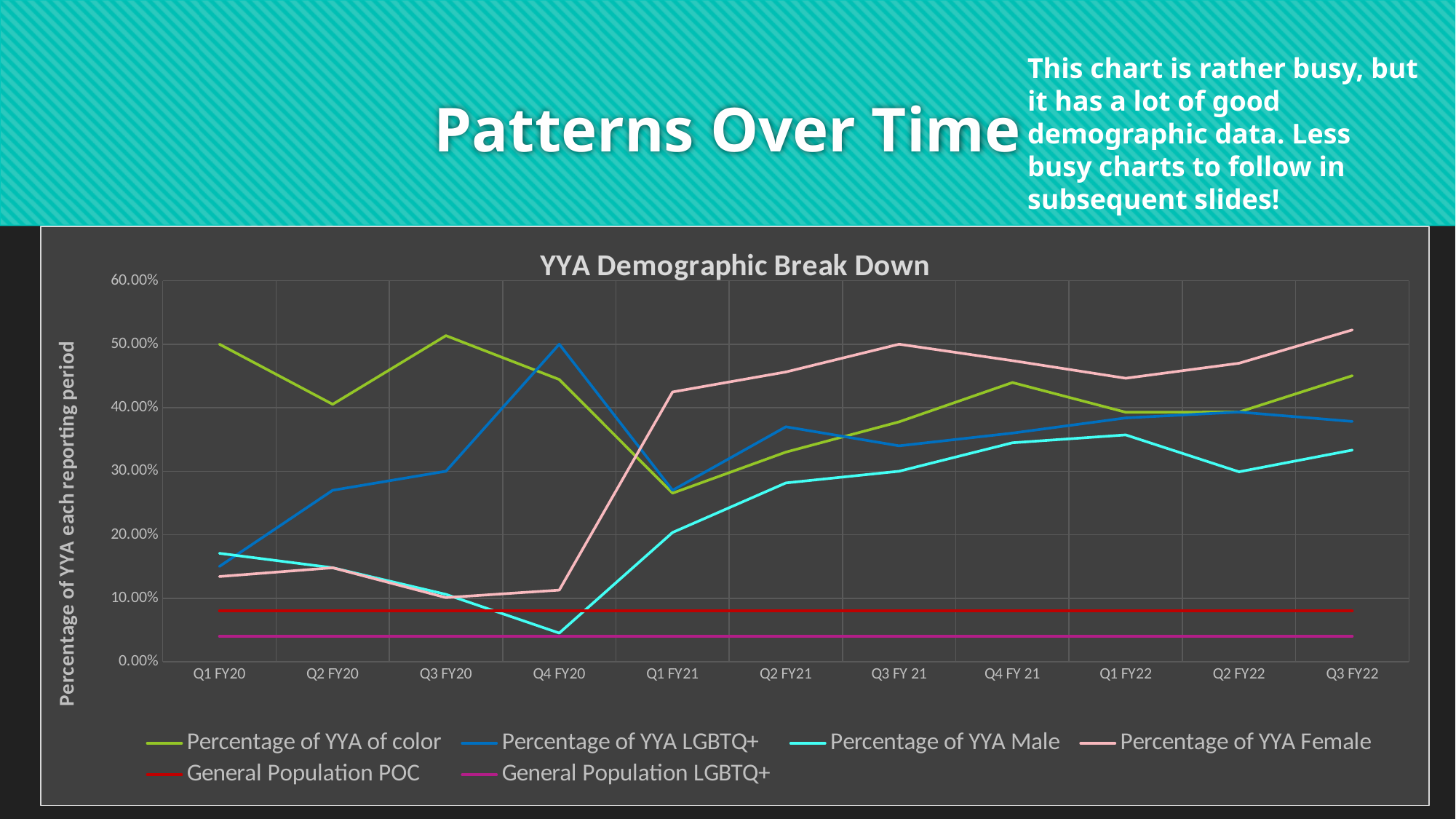
How many series does the legend of the YYA Demographic Break Down chart list? 6 At Q1 FY20, which is higher: Percentage of YYA of color or Percentage of YYA LGBTQ+? Percentage of YYA of color How many reporting periods are shown along the x axis of the chart? 11 Is the value for Percentage of YYA Male at Q4 FY20 greater or less than 10.00%? less What is the title of the chart? YYA Demographic Break Down Which series has the highest value at Q3 FY22? Percentage of YYA Female What is the label on the vertical axis of the chart? Percentage of YYA each reporting period Is the value for General Population POC greater or less than 10.00%? less At Q3 FY22, which is higher: Percentage of YYA Female or Percentage of YYA Male? Percentage of YYA Female Is the value for Percentage of YYA Female at Q3 FY22 greater or less than 50.00%? greater Which series has the lowest value at Q1 FY21? General Population LGBTQ+ What kind of chart is shown on the slide? Line chart